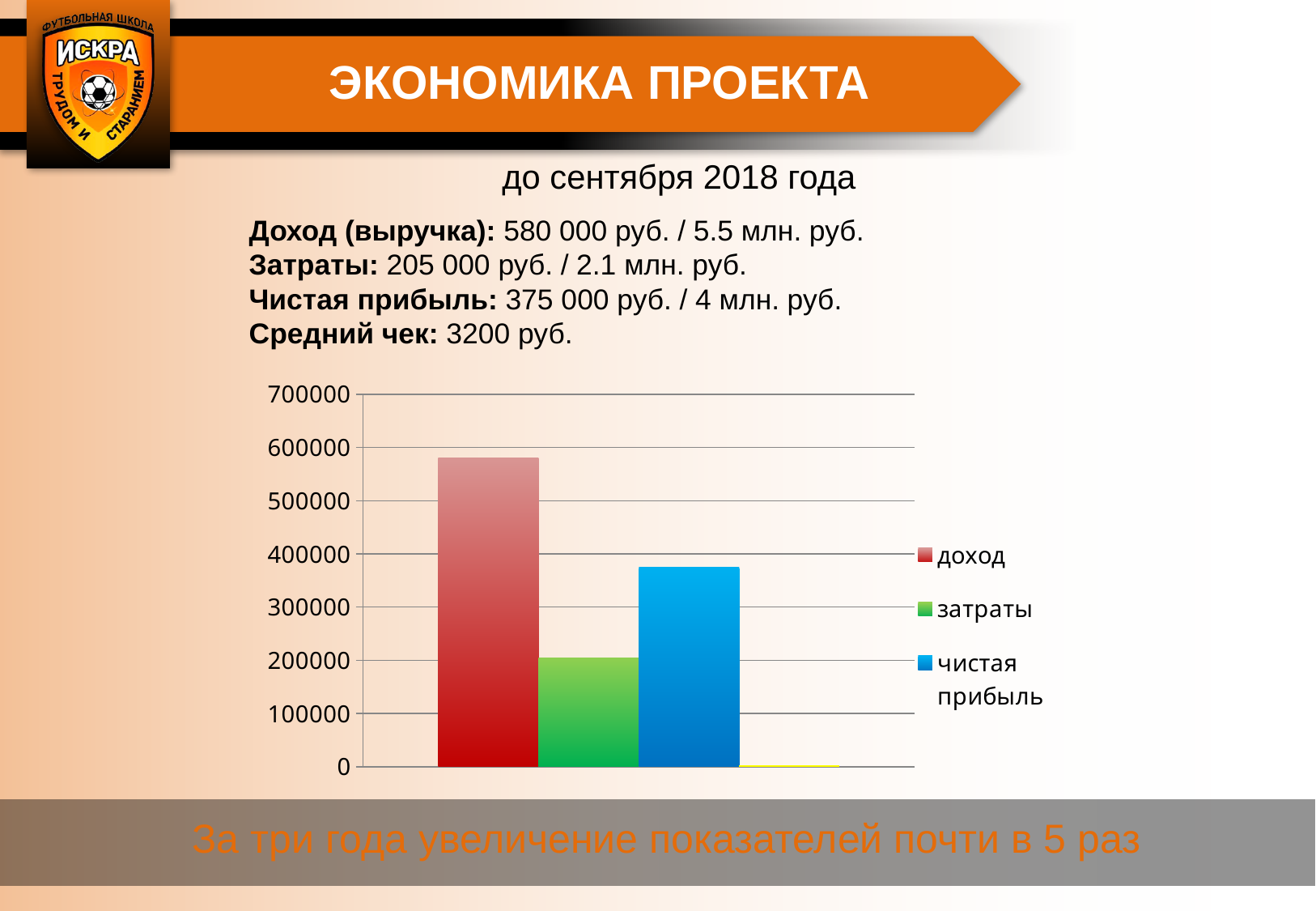
Is the value for чистая прибыль greater or less than 400000? less Of the three series listed in the legend, which has the shortest bar? затраты What is the highest tick value shown on the chart's vertical axis? 700000 Which is larger, затраты or чистая прибыль? чистая прибыль Which series has the tallest bar in the chart? доход What colour is the bar for доход in the chart? red Is the value for чистая прибыль greater or less than 300000? greater Is the value for затраты greater or less than 300000? less Which is larger, доход or чистая прибыль? доход How many series does the chart legend list? 3 What kind of chart is shown on the slide? bar chart